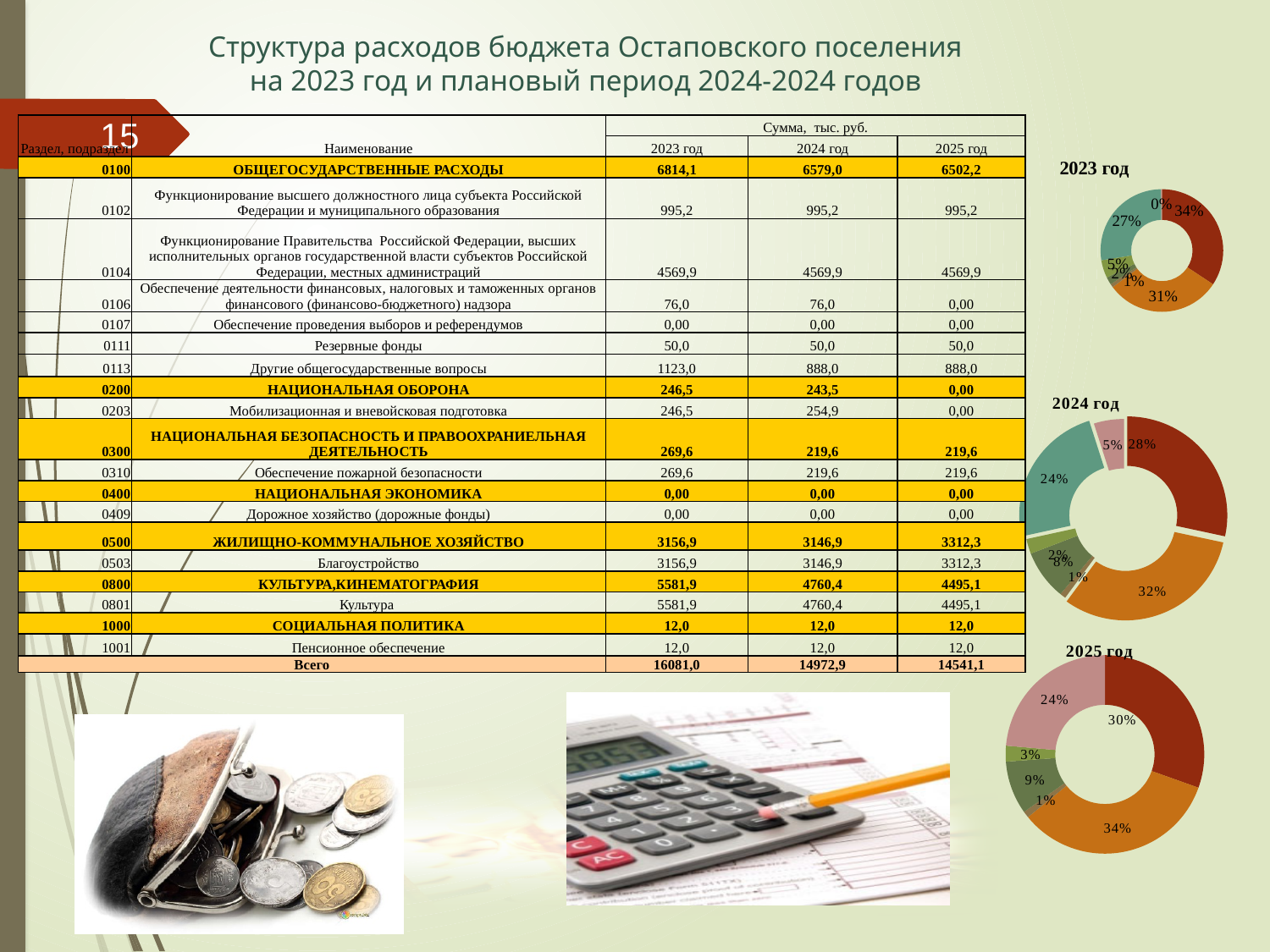
In the "2024 год" chart, what is the largest share shown? 32% In the "2025 год" chart, what is the largest share shown? 34% In the "2023 год" chart, what is the largest share shown? 34% What kind of chart is the "2023 год" chart on the right of the slide? doughnut chart How many pie charts are shown on the slide? 3 In the "2025 год" chart, what is the difference between the two largest shares (34% and 30%)? 4% In the "2023 год" chart, what is the difference between the two largest shares (34% and 31%)? 3% How many slices does the "2025 год" chart have? 6 In the "2024 год" chart, which is larger: the 24% slice or the 28% slice? 28% In the "2025 год" chart, what is the smallest share labelled? 1% What are the titles of the three pie charts on the slide? 2023 год, 2024 год, 2025 год In the "2024 год" chart, what is the second-largest share shown? 28%